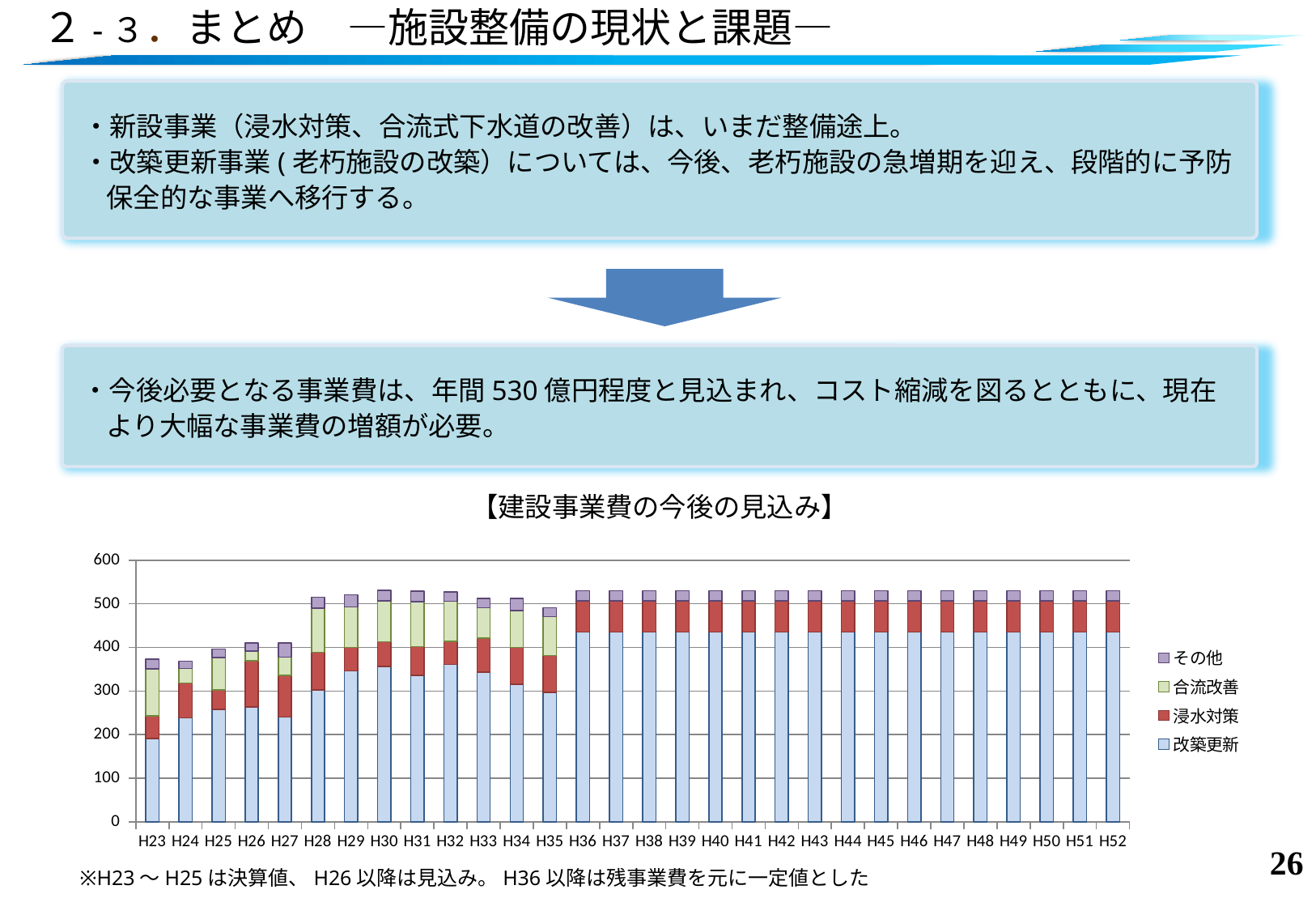
Is the total stacked value for H36 greater or less than 500? greater Which series is listed at the bottom of the chart's legend? 改築更新 Do the total stacked values rise or fall from H23 to H28? rise Is the 改築更新 value for H40 greater or less than 400? greater How many series does the chart's legend list? 4 Is the total stacked value for H28 greater or less than 500? greater What kind of chart is shown under 【建設事業費の今後の見込み】? stacked bar chart How many years (categories) are shown on the x axis of the chart? 30 What is the title shown above the chart? 【建設事業費の今後の見込み】 Which has the larger total stacked value, H23 or H36? H36